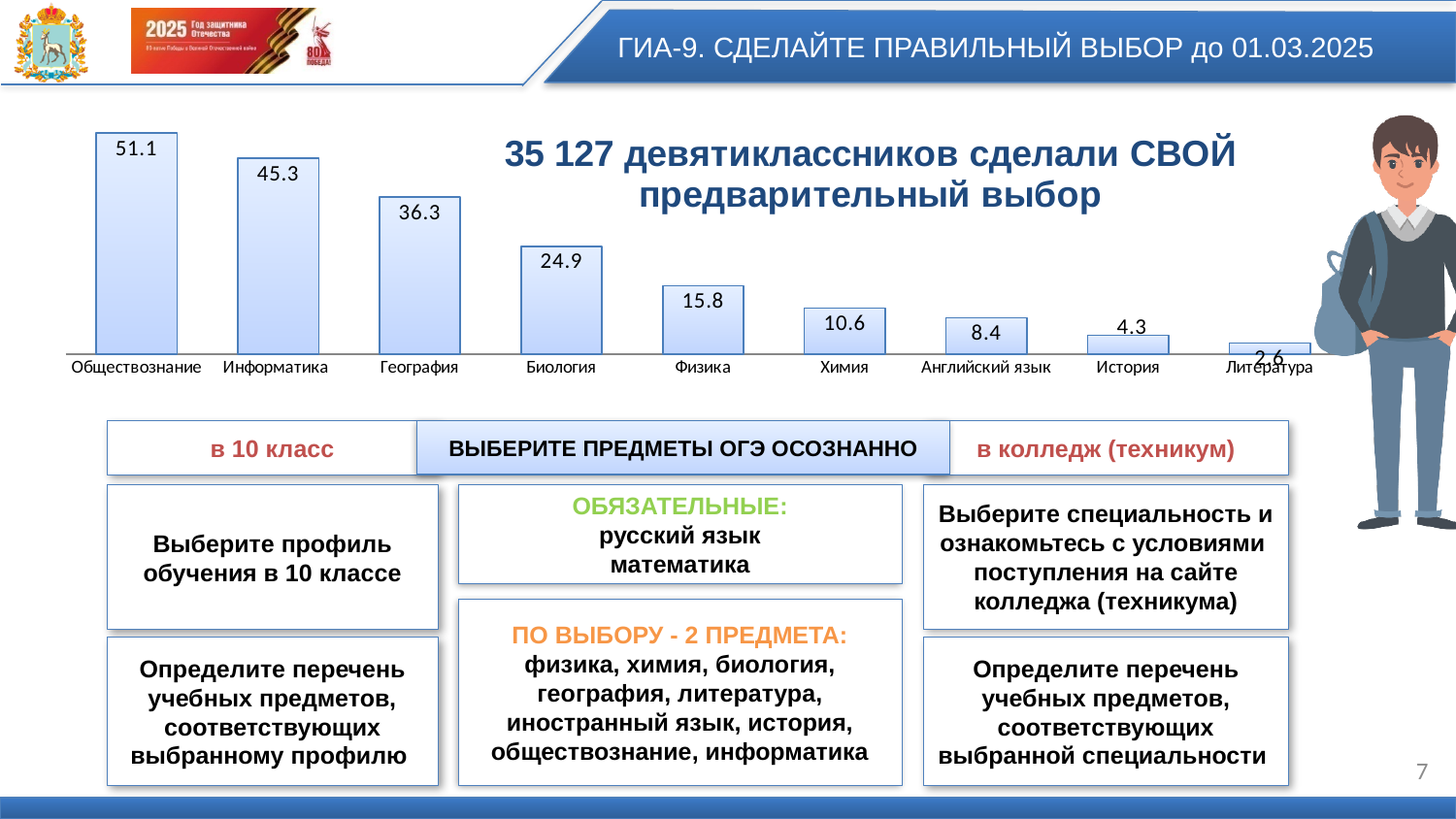
What is the value shown for Биология? 24.9 Which has a larger value, Биология or Информатика? Информатика What is the value shown for Обществознание? 51.1 What is the difference between the values for География and Физика? 20.5 Which subject has the highest value in the chart? Обществознание What type of chart is shown on the slide? Bar chart Do the values rise or fall from left to right across the subjects? Fall What is the value shown for Английский язык? 8.4 Which has a larger value, Химия or История? Химия Which subject has the lowest value in the chart? Литература What is the difference between the values for Обществознание and Информатика? 5.8 How many subjects are shown in the chart? 9